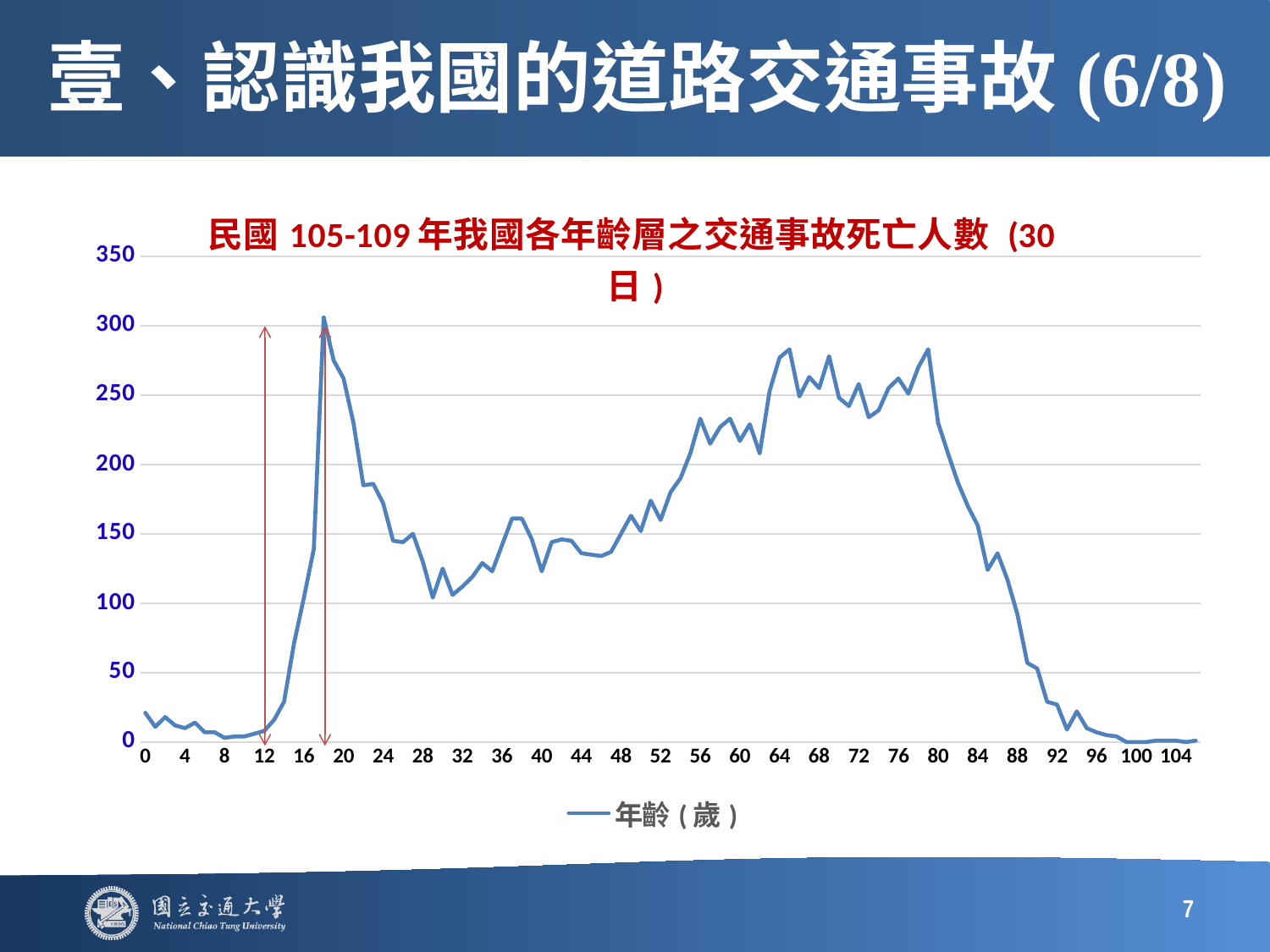
Is the value at age 56 greater or less than 200? greater What kind of chart is shown on the slide? line chart What is the title of the chart? 民國105-109年我國各年齡層之交通事故死亡人數（30日） Is the value at age 12 greater or less than 50? less Which is larger, the value at age 18 or the value at age 65? age 18 At which age does the line reach its highest value? 18 Do the values rise or fall along the x axis from age 80 to age 96? fall What is the legend entry for the plotted line? 年齡（歲） How many series does the legend list? 1 Is the value at age 90 greater or less than 100? less